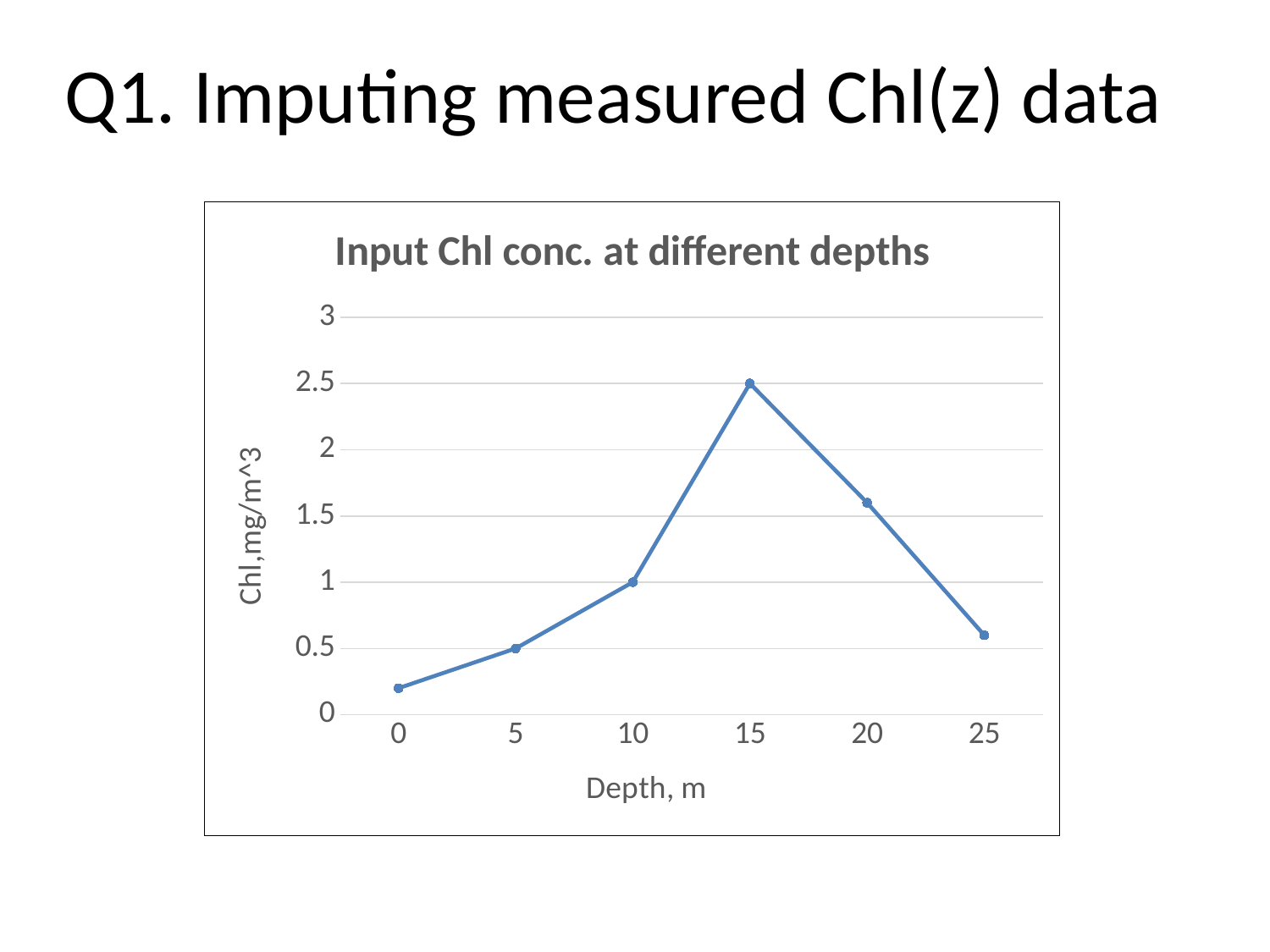
How many data points are plotted on the line? 6 At which depth is the Chl concentration highest? 15 What is the Chl concentration at a depth of 15 m? 2.5 Which depth has the larger Chl concentration, 20 m or 10 m? 20 m What is the label of the x axis? Depth, m What is the difference between the Chl concentration at 15 m and at 10 m? 1.5 Is the Chl concentration at a depth of 20 m greater or less than 1.5? greater Is the Chl concentration at a depth of 0 m greater or less than 0.5? less What type of chart is shown on the slide? Line chart What is the Chl concentration at a depth of 10 m? 1 At which depth is the Chl concentration lowest? 0 What is the title of the chart? Input Chl conc. at different depths